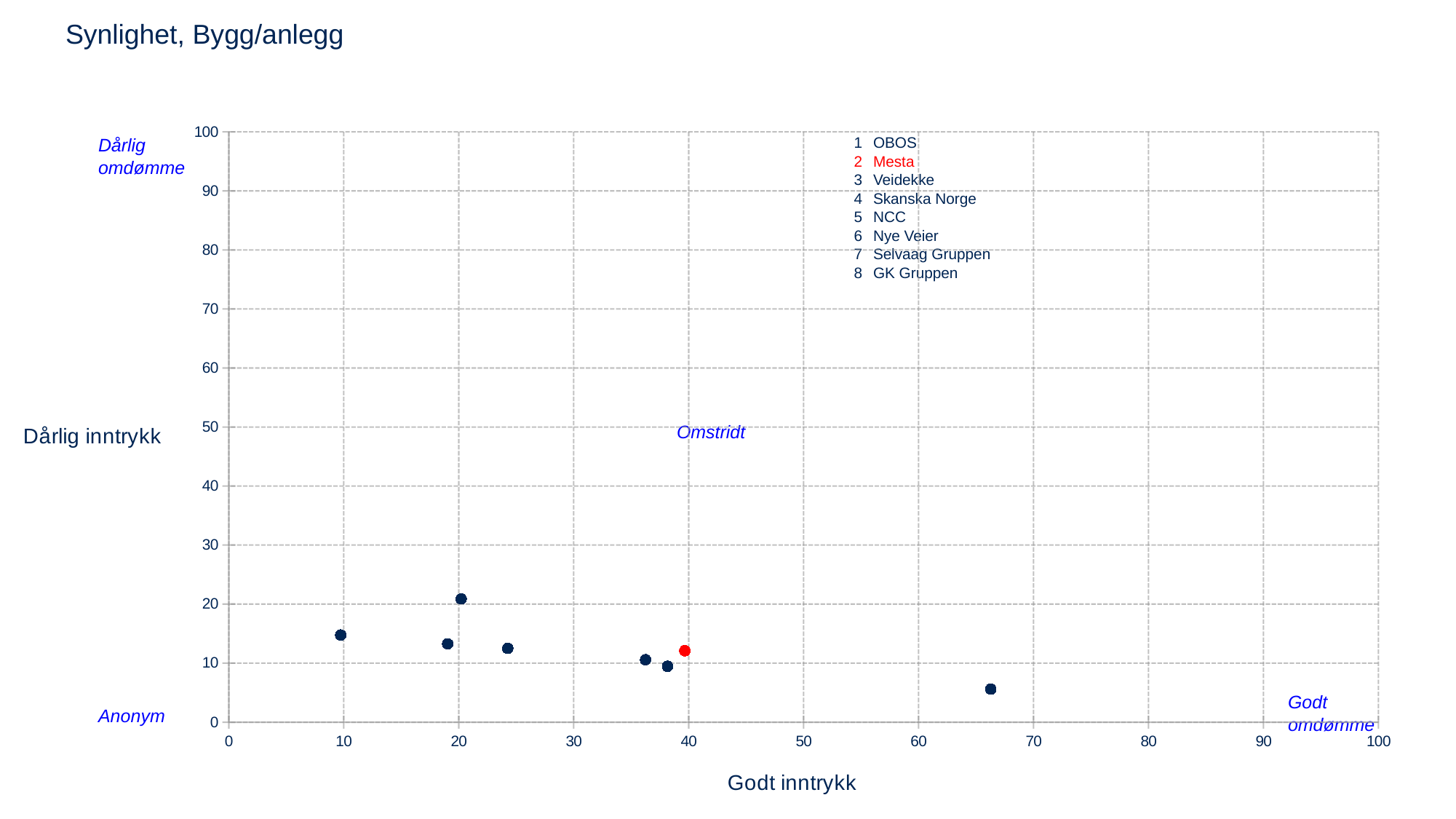
What is the title of the chart? Synlighet, Bygg/anlegg What kind of chart is shown on the slide? scatter chart How many points have an x-axis value greater than 60? 1 Is the x-axis value for the red point (Mesta) greater or less than 30? greater Is the y-axis value for the rightmost point greater or less than 10? less Is the y-axis value for the red point (Mesta) greater or less than 20? less How many companies are listed in the chart's legend? 8 Which company in the legend is shown in red? Mesta How many data points are plotted on the chart? 8